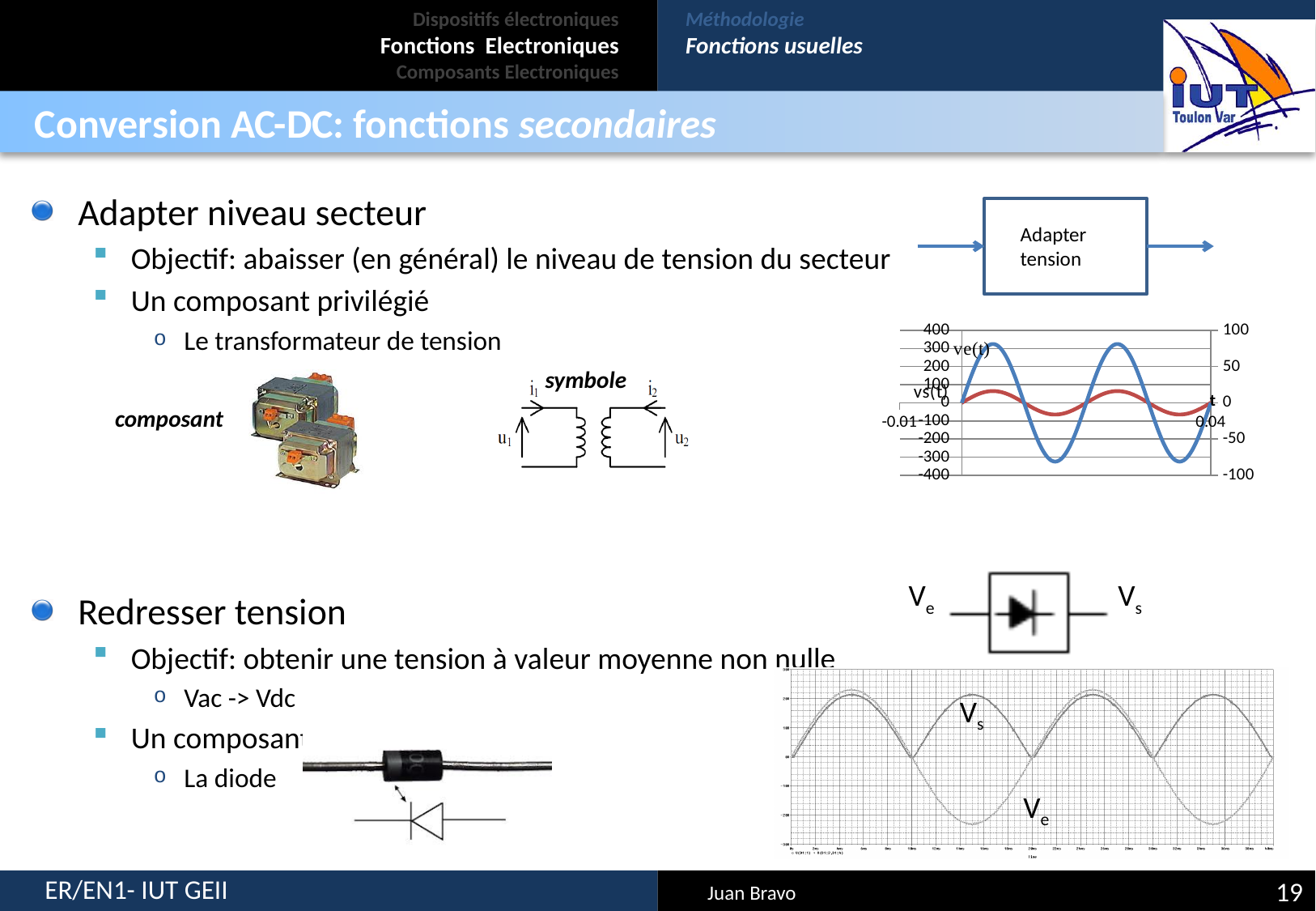
What kind of chart is shown at the top right of the slide, next to the 'Adapter tension' block? line chart In the top-right line chart, which signal has the larger amplitude, ve(t) or vs(t)? ve(t) In the top-right line chart, is the peak value of vs(t) on the left axis greater or less than 200? less In the top-right line chart, what colour is the vs(t) curve? red In the top-right line chart, what colour is the ve(t) curve? blue In the top-right line chart, is the peak value of ve(t) on the left axis greater or less than 200? greater In the top-right line chart, what is the highest value shown on the left vertical axis? 400 In the top-right line chart, how many signals (series) are plotted? 2 In the top-right line chart, is the minimum value of ve(t) on the left axis greater or less than -200? less In the bottom-right oscilloscope plot, which signal has the larger amplitude, Vs or Ve? Ve